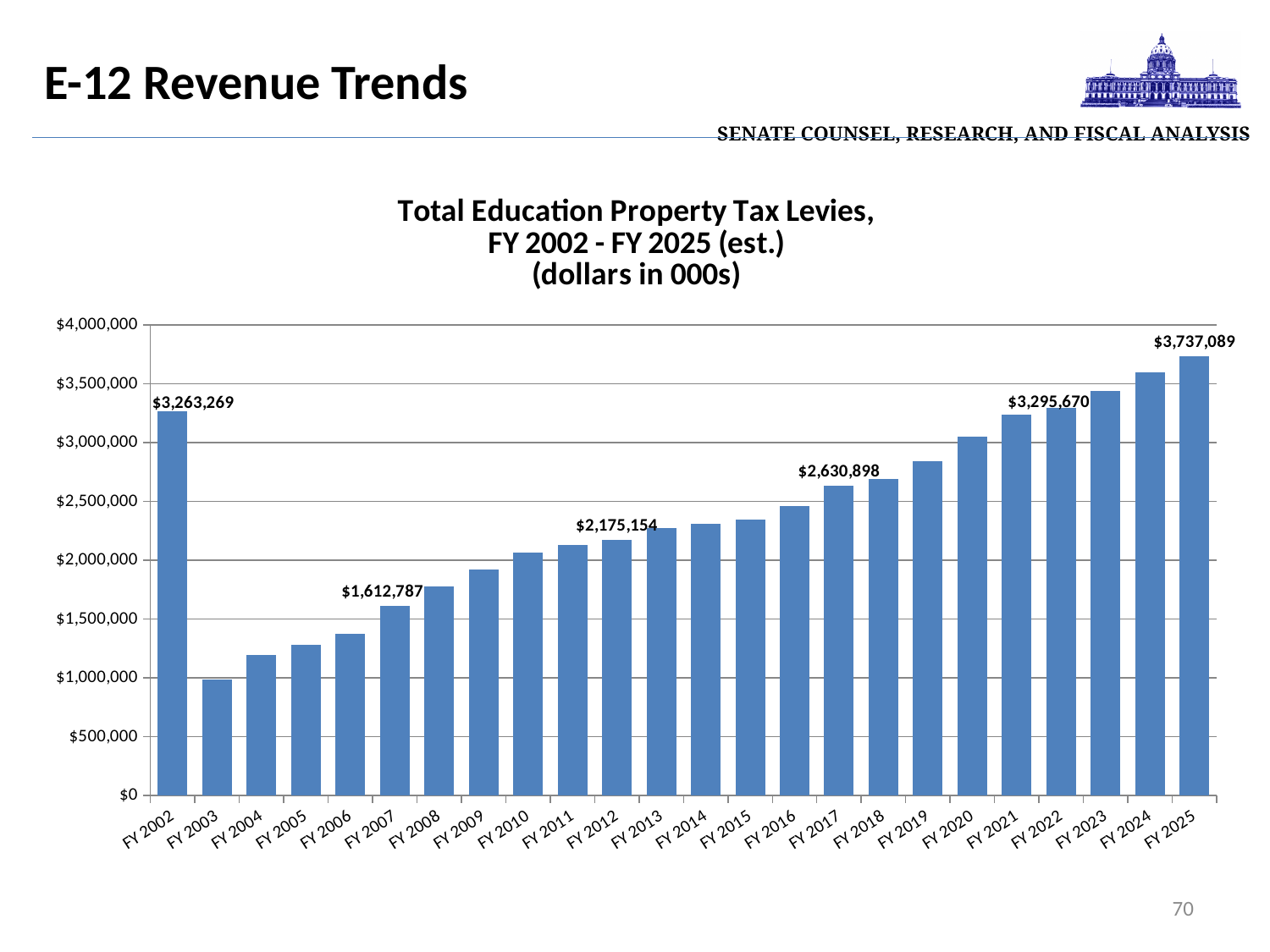
What is the value for FY 2007? $1,612,787 Which is larger, the value for FY 2022 or the value for FY 2002? FY 2022 What type of chart is shown on the slide? Bar chart What is the difference between the values for FY 2025 and FY 2002? $473,820 Which fiscal year has the highest total education property tax levy? FY 2025 What is the difference between the values for FY 2022 and FY 2017? $664,772 Which fiscal year has the lowest total education property tax levy? FY 2003 What is the value for FY 2017? $2,630,898 What is the value for FY 2025? $3,737,089 Is the value for FY 2019 greater or less than $3,000,000? less What is the value for FY 2002? $3,263,269 How many fiscal years are shown on the x axis? 24